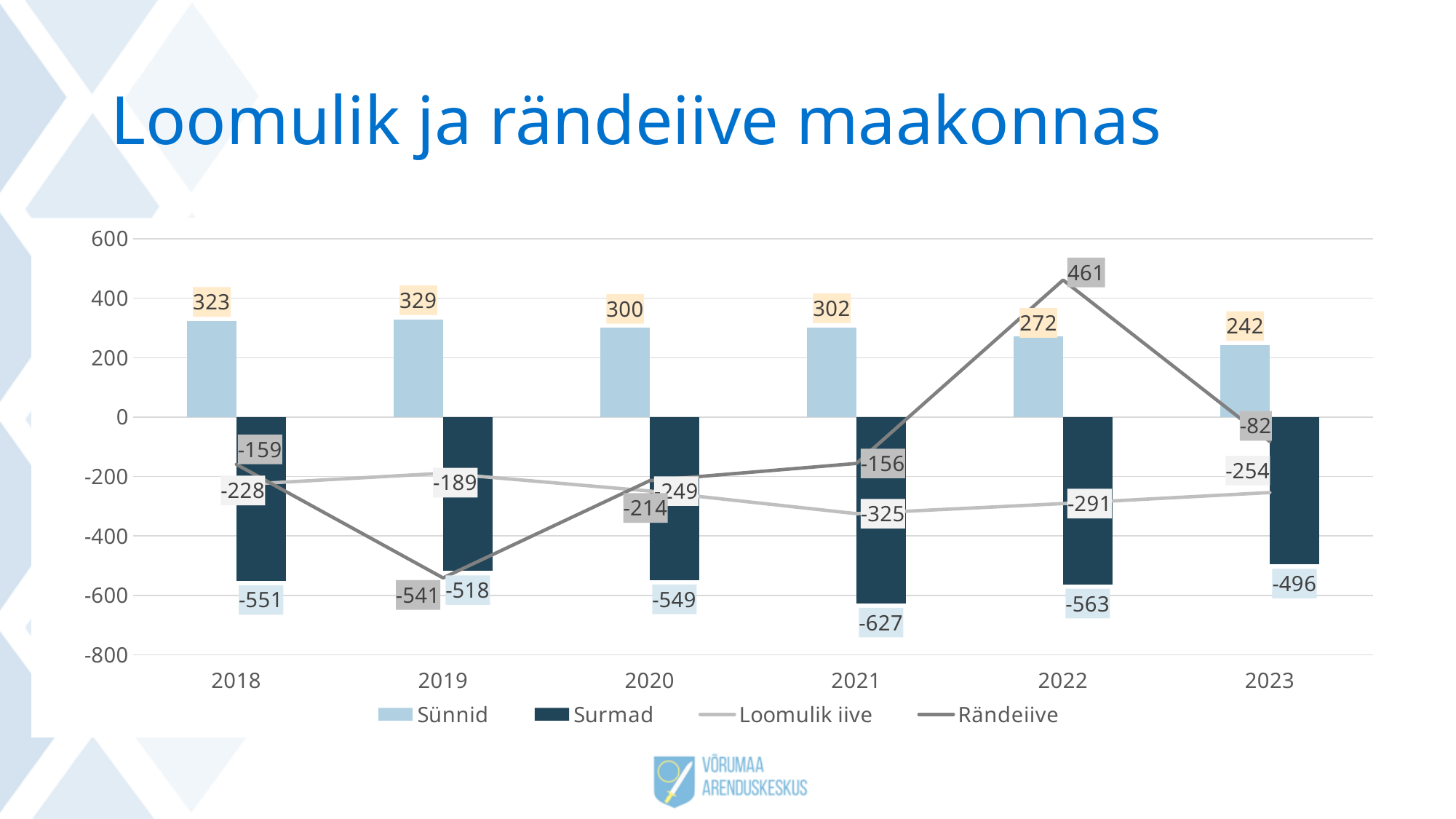
What is the value of Surmad for 2021? -627 What is the value of Rändeiive for 2022? 461 Which is larger in absolute value, Surmad in 2019 or Surmad in 2022? Surmad in 2022 How many series does the legend list? 4 How many years are shown on the x axis? 6 What kind of chart is this? Combined bar and line chart What is the value of Loomulik iive for 2020? -249 Does Sünnid rise or fall from 2021 to 2023? Fall In which year is Sünnid the lowest? 2023 What is the value of Sünnid for 2019? 329 What is the difference between Sünnid in 2018 and Sünnid in 2023? 81 In which year is Rändeiive the highest? 2022